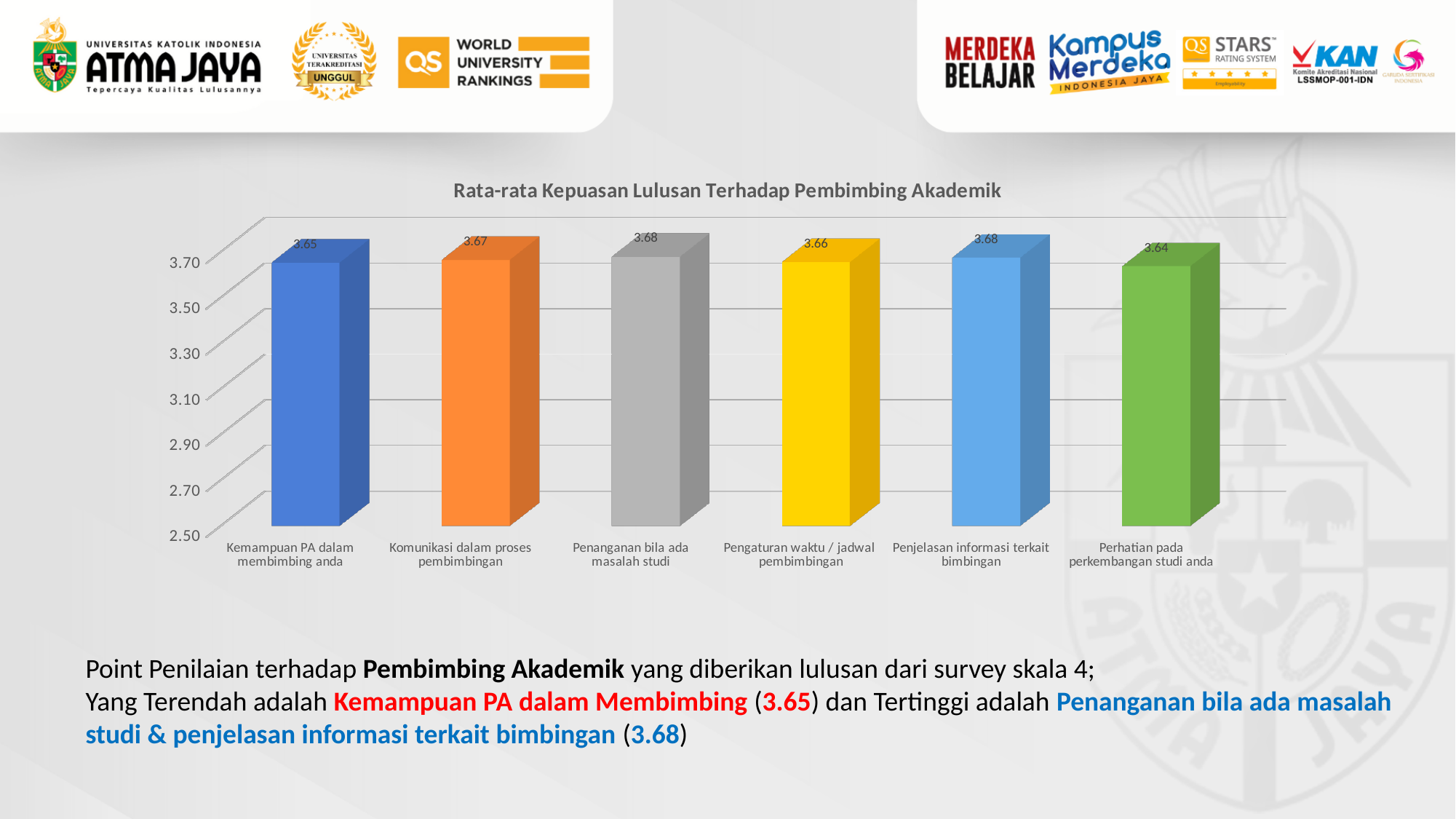
What is the value for "Penanganan bila ada masalah studi"? 3.68 What is the value for "Kemampuan PA dalam membimbing anda"? 3.65 What is the value for "Pengaturan waktu / jadwal pembimbingan"? 3.66 How many categories are shown in the chart? 6 What kind of chart is shown on the slide? bar chart What is the title of the chart? Rata-rata Kepuasan Lulusan Terhadap Pembimbing Akademik What is the difference between the values for "Penanganan bila ada masalah studi" and "Kemampuan PA dalam membimbing anda"? 0.03 What is the value for "Penjelasan informasi terkait bimbingan"? 3.68 Which is larger, the value for "Komunikasi dalam proses pembimbingan" or the value for "Pengaturan waktu / jadwal pembimbingan"? Komunikasi dalam proses pembimbingan Is the value for "Perhatian pada perkembangan studi anda" greater or less than 3.50? greater What is the value for "Perhatian pada perkembangan studi anda"? 3.64 What is the value for "Komunikasi dalam proses pembimbingan"? 3.67